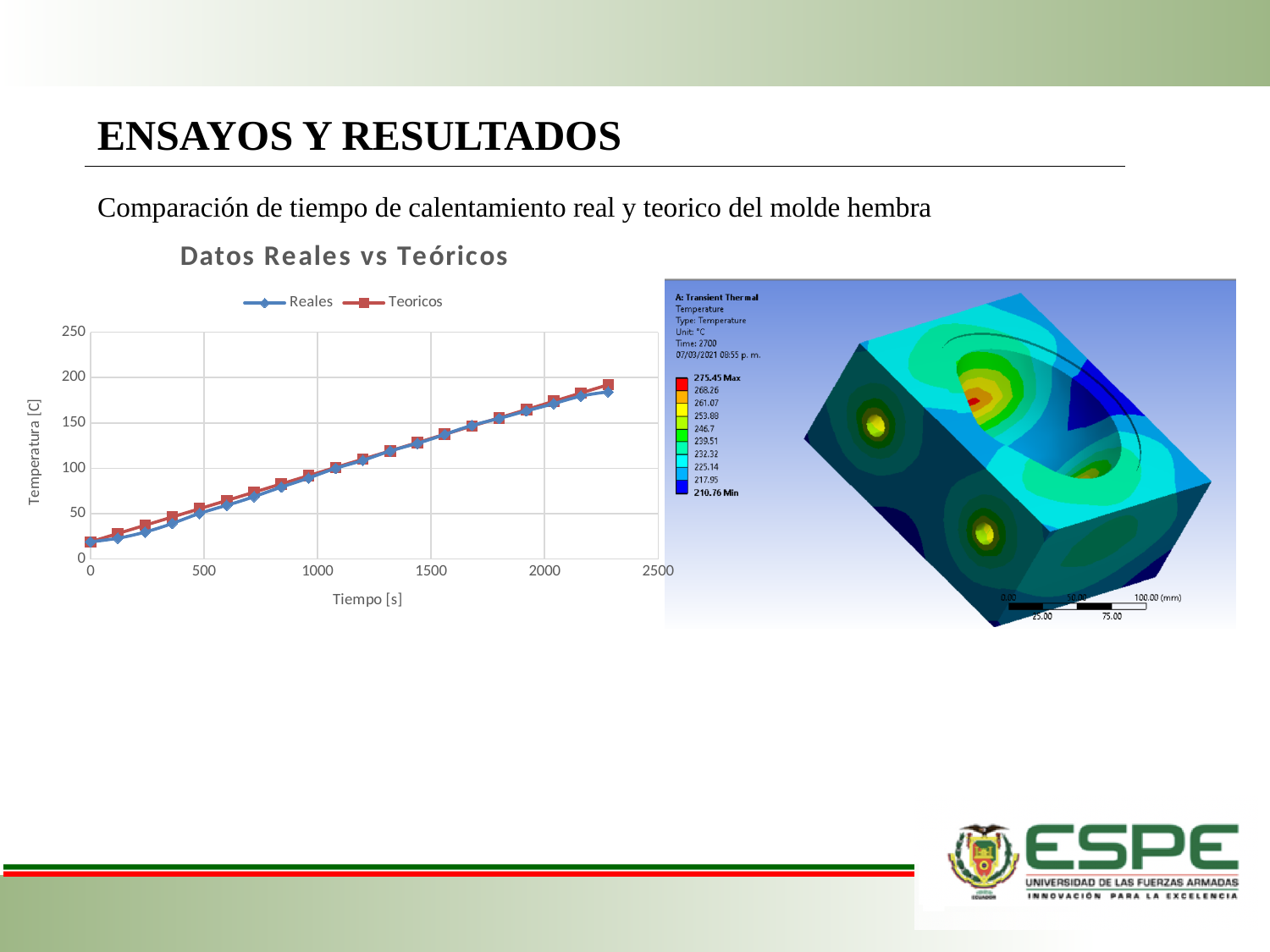
What is the label of the x axis in the 'Datos Reales vs Teóricos' chart? Tiempo [s] In the 'Datos Reales vs Teóricos' chart, do the temperature values rise or fall as time increases? rise In the 'Datos Reales vs Teóricos' chart, is the Teoricos value at around 2000 s greater or less than 150? greater In the 'Datos Reales vs Teóricos' chart, is the Teoricos value at the last plotted time greater or less than 150? greater What kind of chart is 'Datos Reales vs Teóricos'? line chart In the 'Datos Reales vs Teóricos' chart, is the Reales value at around 1500 s greater or less than 150? less How many series does the legend of the 'Datos Reales vs Teóricos' chart list? 2 In the 'Datos Reales vs Teóricos' chart, at the last plotted time, which series has the larger value, Reales or Teoricos? Teoricos What are the two series named in the legend of the 'Datos Reales vs Teóricos' chart? Reales and Teoricos In the 'Datos Reales vs Teóricos' chart, which series reaches the highest temperature? Teoricos